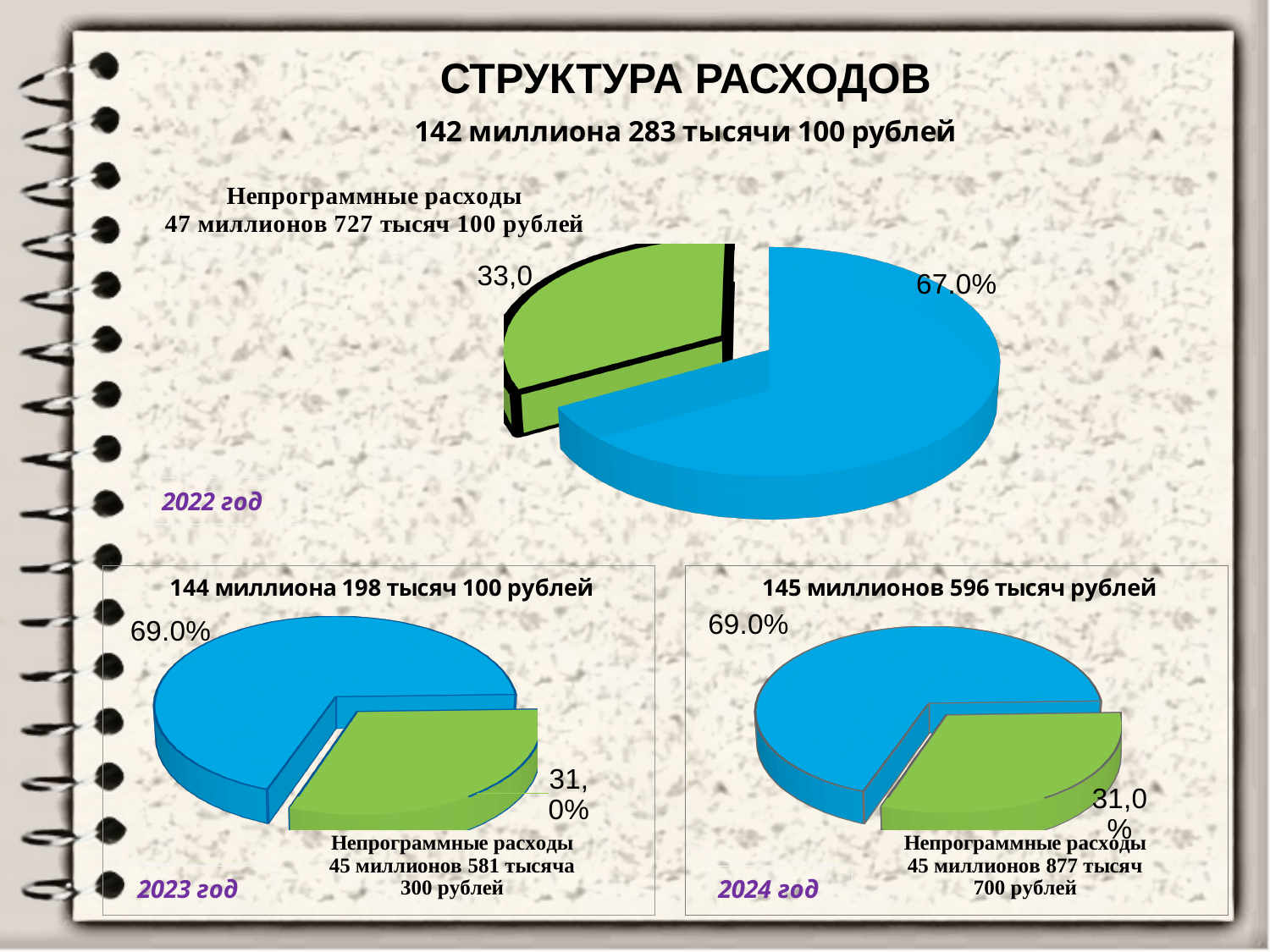
In the 2024 chart (bottom right), what share is shown for Непрограммные расходы (green slice)? 31,0% In the 2024 chart (bottom right), what percentage is shown for the blue slice? 69.0% How many pie charts are shown on the slide? 3 In the 2022 chart (top), which slice is larger, the blue one or the green one? the blue one In the 2022 chart (top), what share is shown for the green slice (Непрограммные расходы)? 33,0% In the 2023 chart (bottom left), what is the difference in percentage points between the blue slice and the green slice? 38.0 percentage points In the 2023 chart (bottom left), what percentage is shown for the blue slice? 69.0% What kind of chart is used to show the expense structure for 2022 (top chart)? pie chart In the 2022 chart (top), what percentage is shown for the blue slice? 67.0% In the 2023 chart (bottom left), what share is shown for Непрограммные расходы (green slice)? 31,0% What total amount of expenses is given in the title above the 2022 chart (top)? 142 миллиона 283 тысячи 100 рублей How many slices does the 2023 chart (bottom left) have? 2